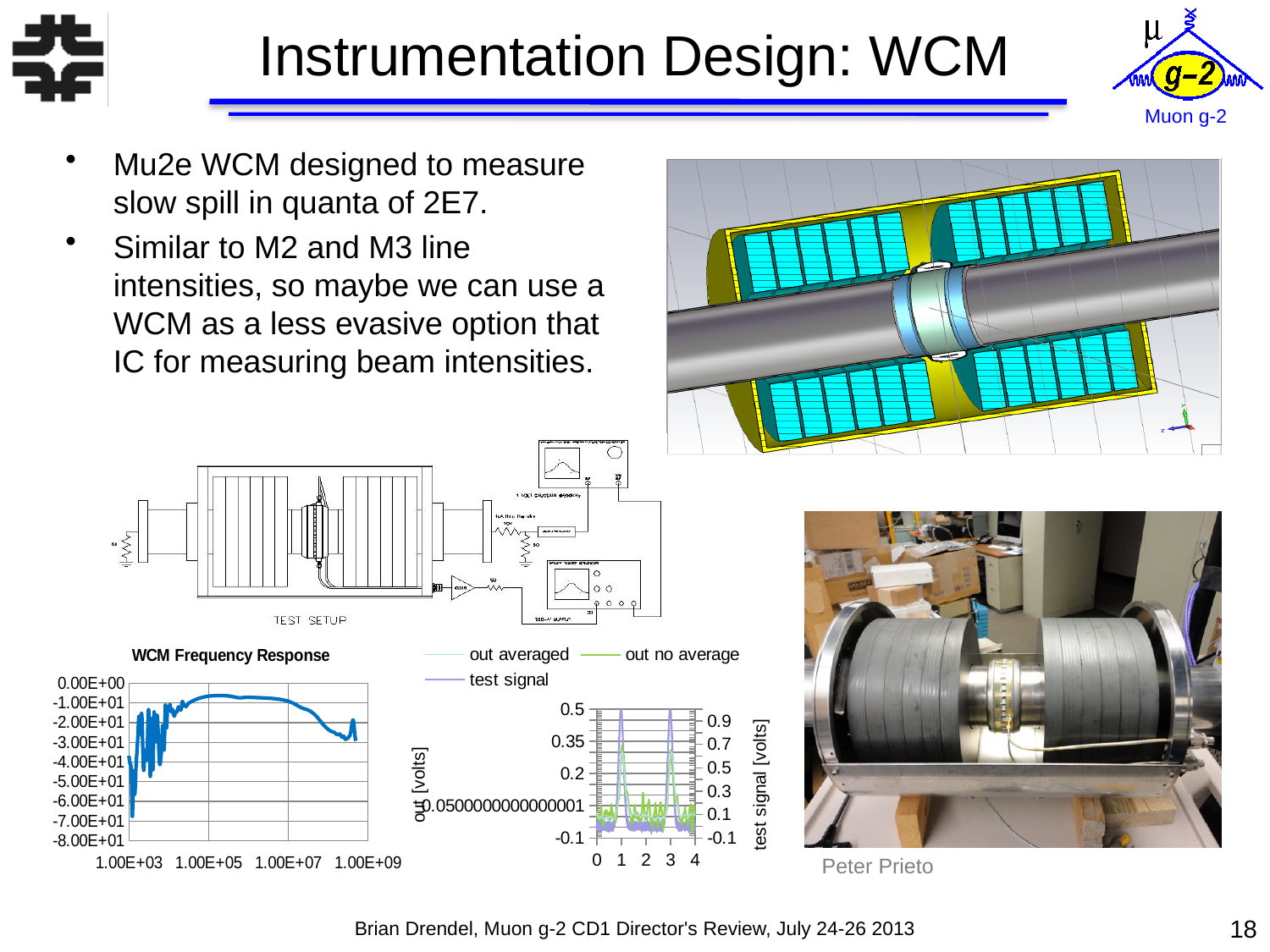
In the "WCM Frequency Response" chart, what is the lowest value shown on the y axis? -8.00E+01 What are the legend entries of the chart at the bottom centre (with "out [volts]" axis)? out averaged, out no average, test signal How many series does the legend of the chart at the bottom centre (with "out [volts]" axis) list? 3 In the "WCM Frequency Response" chart, does the curve rise or fall between 1.00E+07 and 1.00E+09? fall In the "WCM Frequency Response" chart, is the value at 1.00E+05 greater or less than -2.00E+01? greater What kind of chart is the "WCM Frequency Response" chart? line chart What kind of chart is the chart at the bottom centre with the "test signal [volts]" axis? line chart